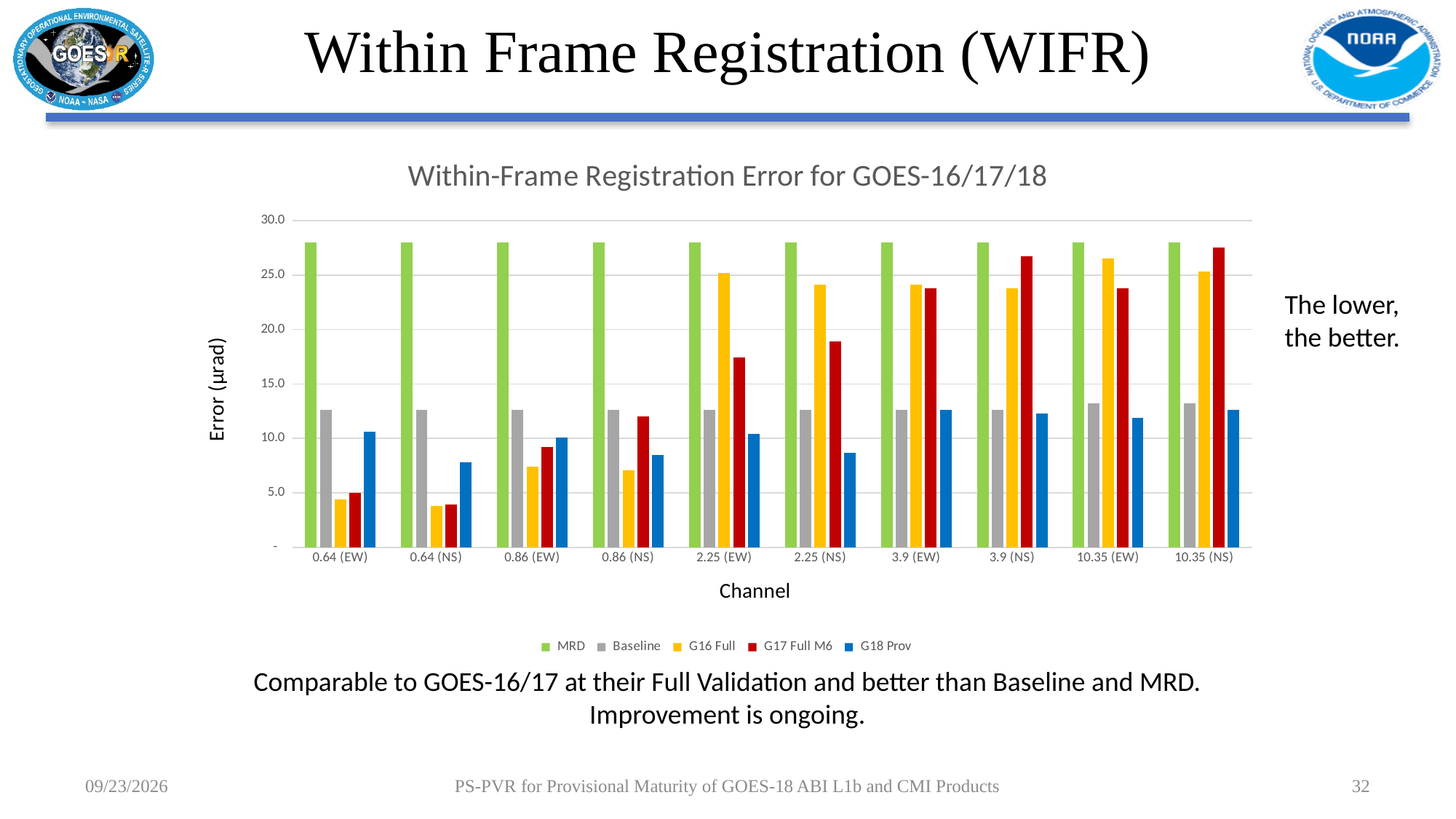
Is the value for Baseline at 0.86 (EW) greater or less than 15.0? less What kind of chart is shown on the slide? Bar chart Is the value for G16 Full at 0.64 (NS) greater or less than 5.0? less What is the title of the chart? Within-Frame Registration Error for GOES-16/17/18 Is the value for G17 Full M6 at 2.25 (EW) greater or less than 15.0? greater How many channel categories are shown on the x axis? 10 At 0.64 (EW), which is larger: G16 Full or G18 Prov? G18 Prov At 3.9 (NS), which is larger: G17 Full M6 or G18 Prov? G17 Full M6 What is the label of the y axis? Error (μrad) How many series does the chart legend list? 5